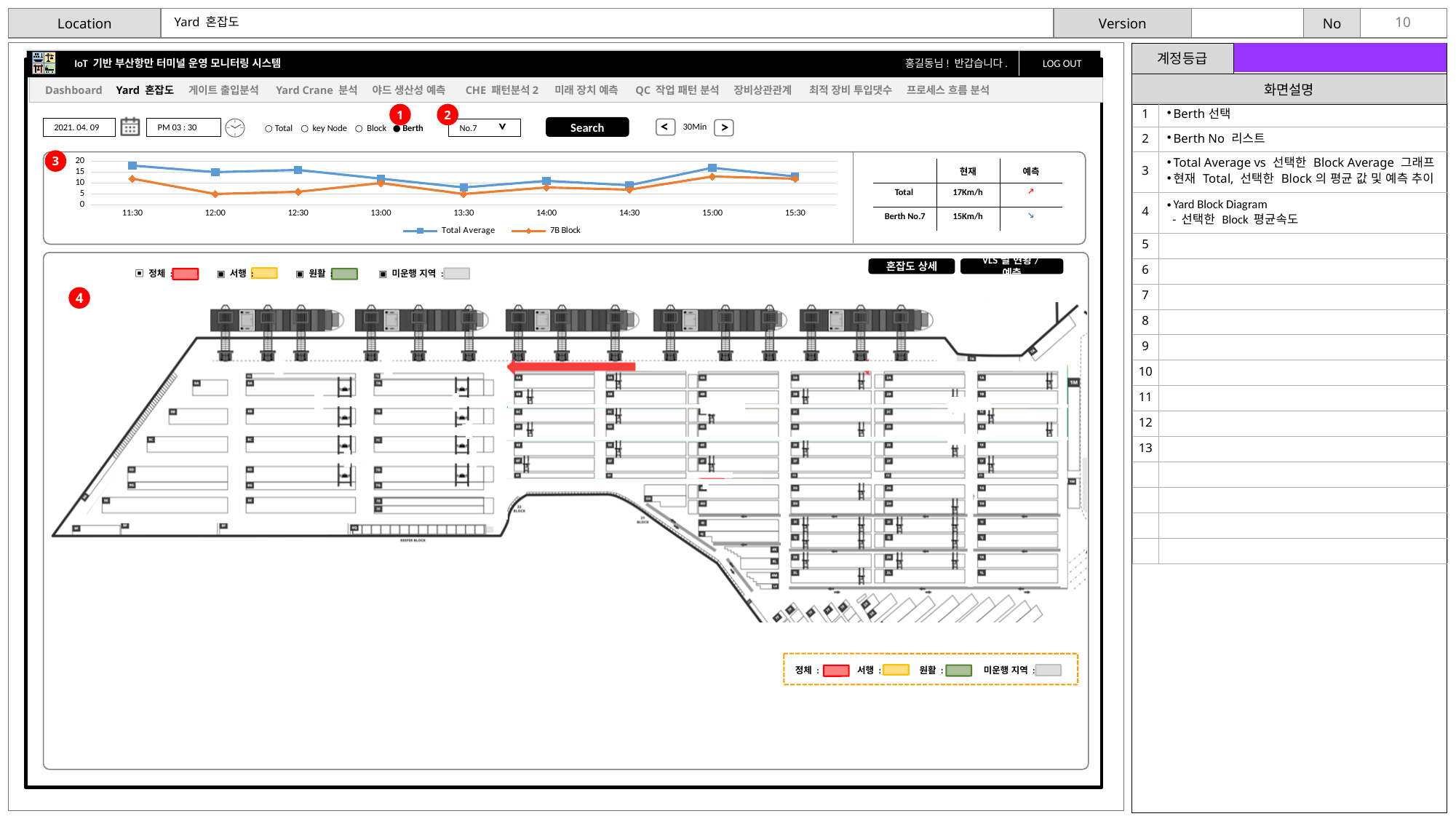
Does the Total Average line rise or fall between 11:30 and 13:30? fall How many time points are plotted along the x axis of the line chart? 9 Is the Total Average value at 11:30 greater or less than 15? greater What colour is the Total Average line in the chart? blue What kind of chart is shown at the top of the monitoring screen? line chart Is the Total Average value at 13:30 greater or less than 10? less How many series does the legend of the line chart list? 2 Is the 7B Block value at 12:00 greater or less than 10? less Which two series are listed in the legend of the line chart? Total Average and 7B Block Does the 7B Block line rise or fall between 13:30 and 15:00? rise At 11:30, which series has the higher value, Total Average or 7B Block? Total Average